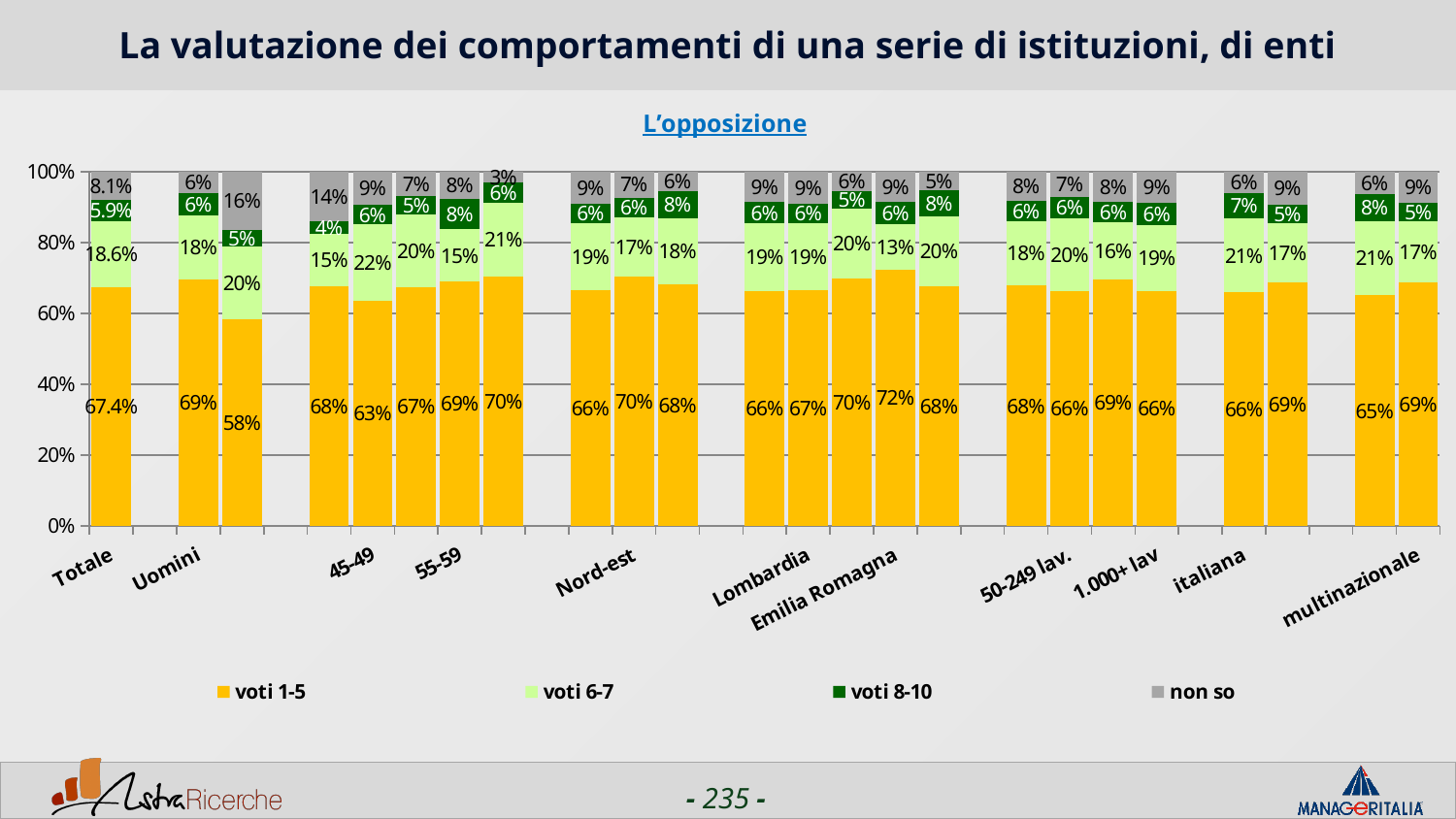
What is the highest 'voti 1-5' value shown in any bar? 72% What is the subtitle shown above the chart? L'opposizione What is the 'non so' value for Totale? 8.1% How many series does the legend list? 4 What is the 'voti 1-5' value for Uomini? 69% For Totale, which is larger: 'voti 6-7' or 'voti 8-10'? voti 6-7 What is the 'voti 1-5' value for Totale? 67.4% What is the 'voti 6-7' value for Totale? 18.6% What is the 'voti 6-7' value for Uomini? 18% What is the lowest 'voti 1-5' value shown in any bar? 58% What is the 'voti 8-10' value for Totale? 5.9% What kind of chart is shown on the slide? Stacked bar chart